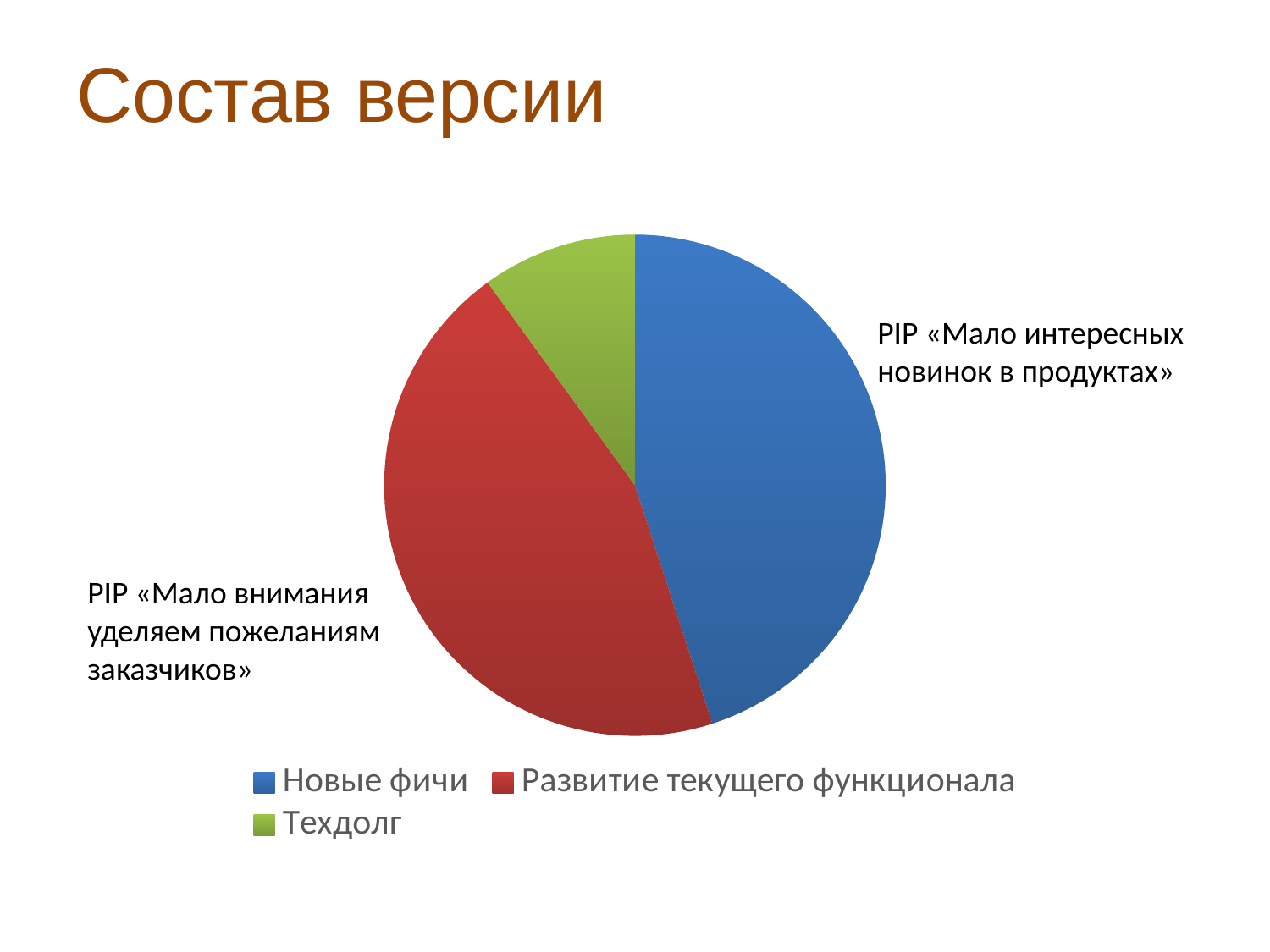
What is the title of the slide containing the pie chart? Состав версии Which slice is larger in the pie chart: Техдолг or Новые фичи? Новые фичи Which category has the smallest slice in the pie chart? Техдолг What kind of chart is shown on the slide? pie chart How many entries does the legend of the pie chart list? 3 Which slice is larger in the pie chart: Развитие текущего функционала or Техдолг? Развитие текущего функционала How many slices does the pie chart have? 3 Which colour represents Техдолг in the pie chart? green